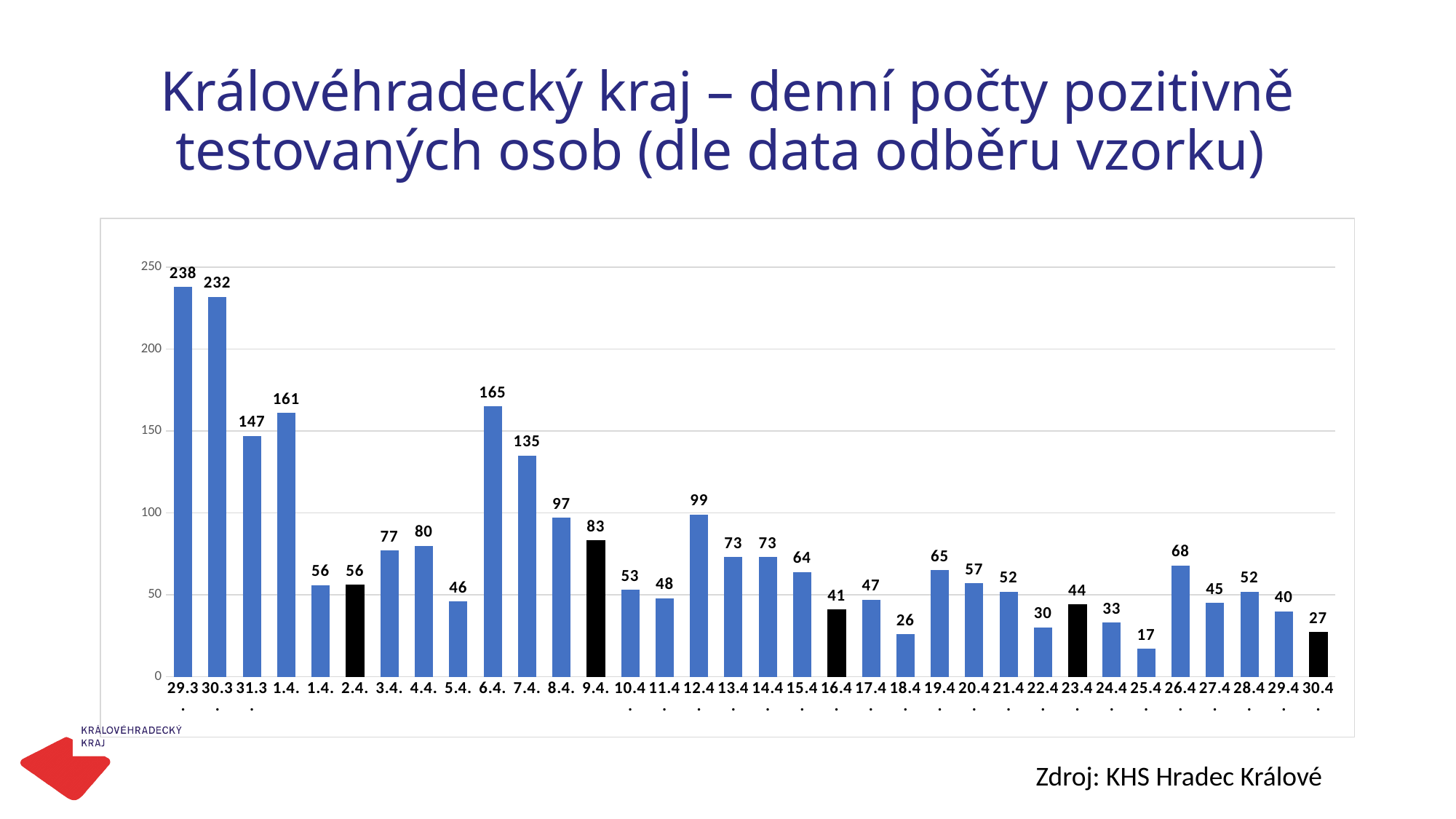
Is the value for 26.4 greater or less than 50? greater Do the values generally rise or fall from left to right along the x axis? fall What is the value for 19.4? 65 Which is larger, the value for 7.4. or the value for 8.4.? 7.4. What kind of chart is shown on the slide? bar chart Which date has the highest value? 29.3 What is the value for 12.4? 99 What is the difference between the values for 29.3 and 30.3? 6 What is the difference between the values for 6.4. and 7.4.? 30 What is the value for 6.4.? 165 How many bars are plotted in the chart? 34 Which date has the lowest value? 25.4